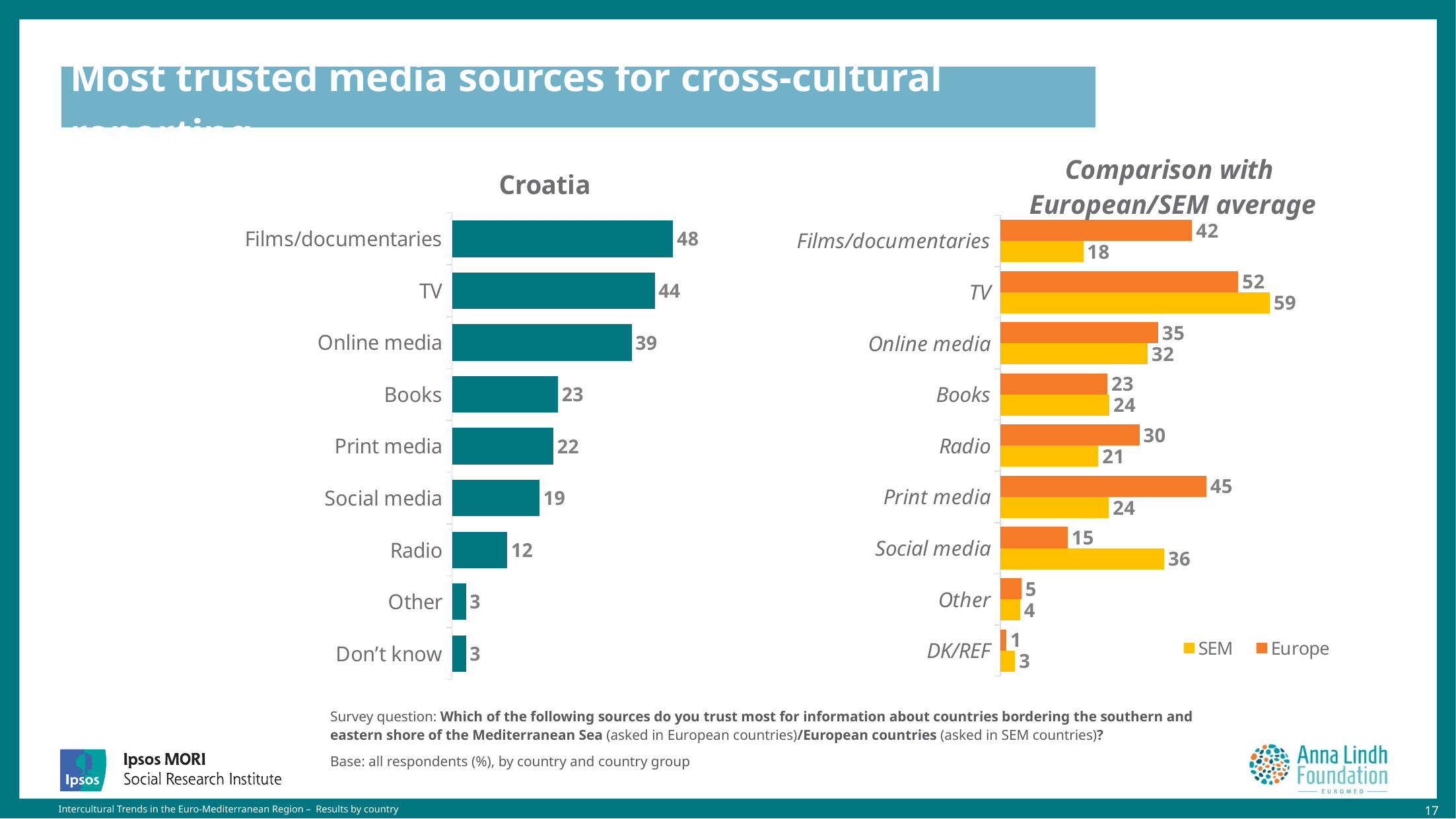
In the Croatia chart, what is the difference between the values for TV and Radio? 32 In the Croatia chart, what is the value for Online media? 39 In the Comparison with European/SEM average chart, which category has the highest SEM value? TV In the Comparison with European/SEM average chart, what is the difference between the Europe and SEM values for Films/documentaries? 24 What kind of chart is the Croatia chart? Bar chart In the Croatia chart, what is the value for Films/documentaries? 48 In the Comparison with European/SEM average chart, what is the SEM value for Social media? 36 In the Croatia chart, which category has the highest value? Films/documentaries In the Croatia chart, how many categories are shown? 9 In the Comparison with European/SEM average chart, what is the Europe value for Print media? 45 How many series does the legend of the Comparison with European/SEM average chart list? 2 In the Croatia chart, which is larger, Books or Print media? Books